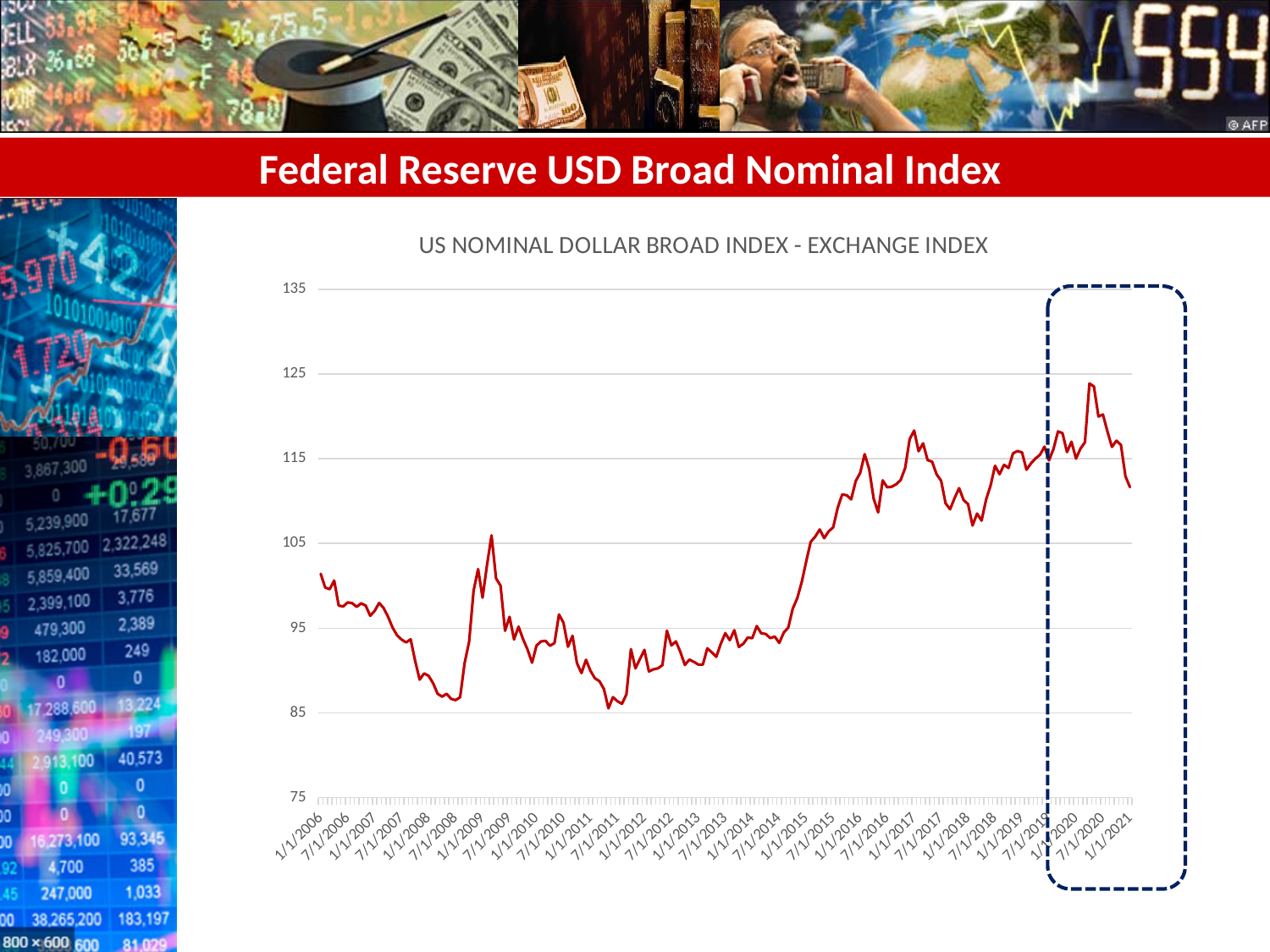
Is the highest point of the line greater or less than 115? greater Is the value of the index at 1/1/2021 greater or less than 105? greater What is the title of the chart? US NOMINAL DOLLAR BROAD INDEX - EXCHANGE INDEX Is the value at 1/1/2016 larger or smaller than the value at 1/1/2011? larger What kind of chart is shown on the slide? line chart Is the value of the index at 7/1/2011 greater or less than 95? less Overall, does the index rise or fall from 1/1/2006 to 1/1/2021? rise How many date labels are shown along the horizontal axis? 31 Does the index rise or fall between 1/1/2006 and 1/1/2008? fall What is the highest value shown on the vertical axis? 135 In which year does the line reach its highest value? 2020